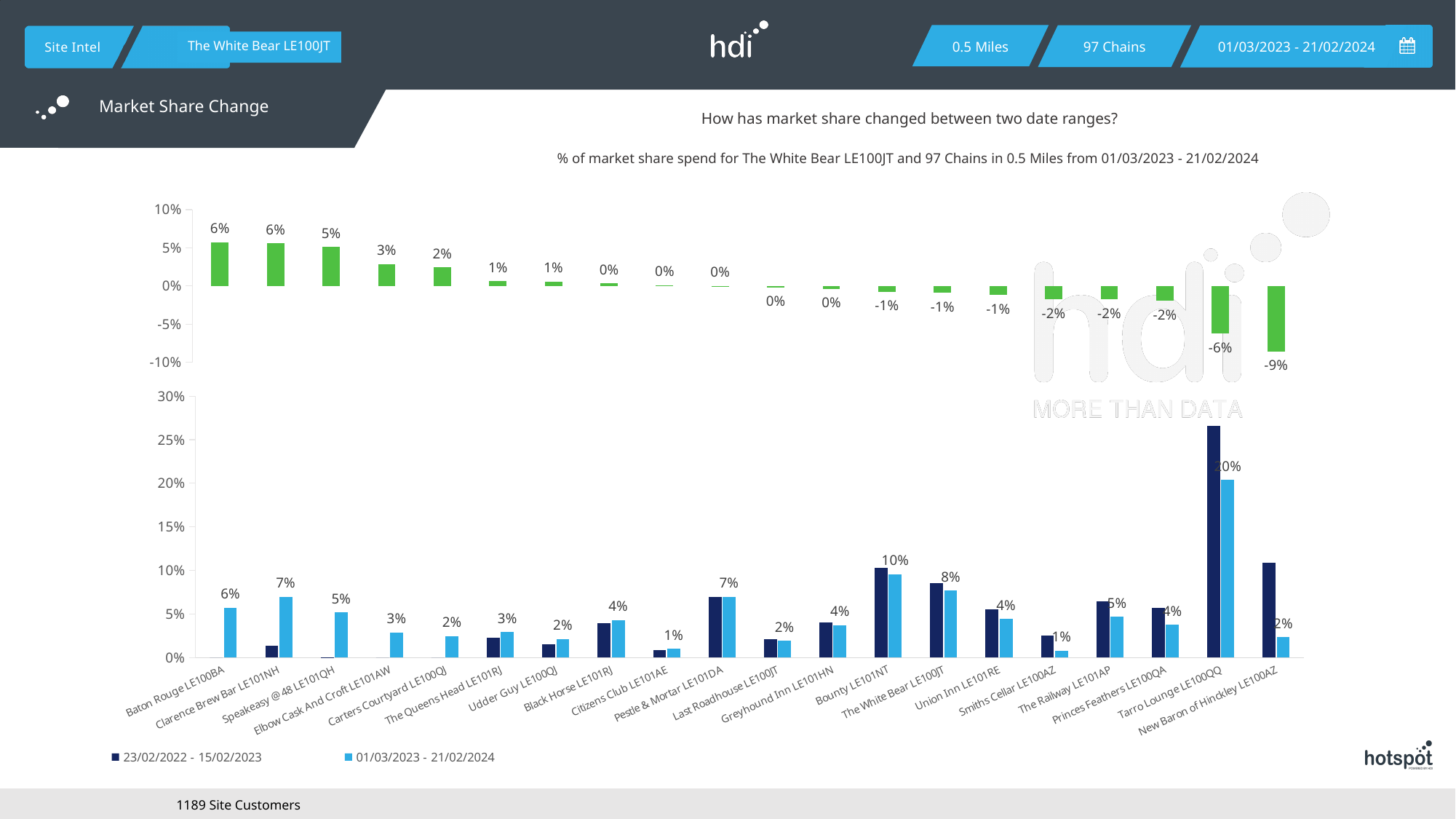
In the top chart (market share change), which category has the lowest value? New Baron of Hinckley LE100AZ In the top chart (market share change), what is the value for Baton Rouge LE100BA? 6% How many categories are shown on the x axis of the bottom chart? 20 In the top chart (market share change), what is the value for Tarro Lounge LE100QQ? -6% How many series does the legend of the bottom chart list? 2 What are the two legend entries of the bottom chart? 23/02/2022 - 15/02/2023 and 01/03/2023 - 21/02/2024 In the bottom chart, what is the value for Bounty LE101NT in the 01/03/2023 - 21/02/2024 series? 10% What kind of chart is the bottom chart? bar chart In the top chart (market share change), what is the difference between the values for Speakeasy @48 LE101QH and Elbow Cask And Croft LE101AW? 2% In the bottom chart, what is the value for Tarro Lounge LE100QQ in the 01/03/2023 - 21/02/2024 series? 20% In the bottom chart, which has the larger value in the 01/03/2023 - 21/02/2024 series: Clarence Brew Bar LE101NH or Baton Rouge LE100BA? Clarence Brew Bar LE101NH In the bottom chart, is the value for Tarro Lounge LE100QQ in the 23/02/2022 - 15/02/2023 series greater or less than 25%? greater